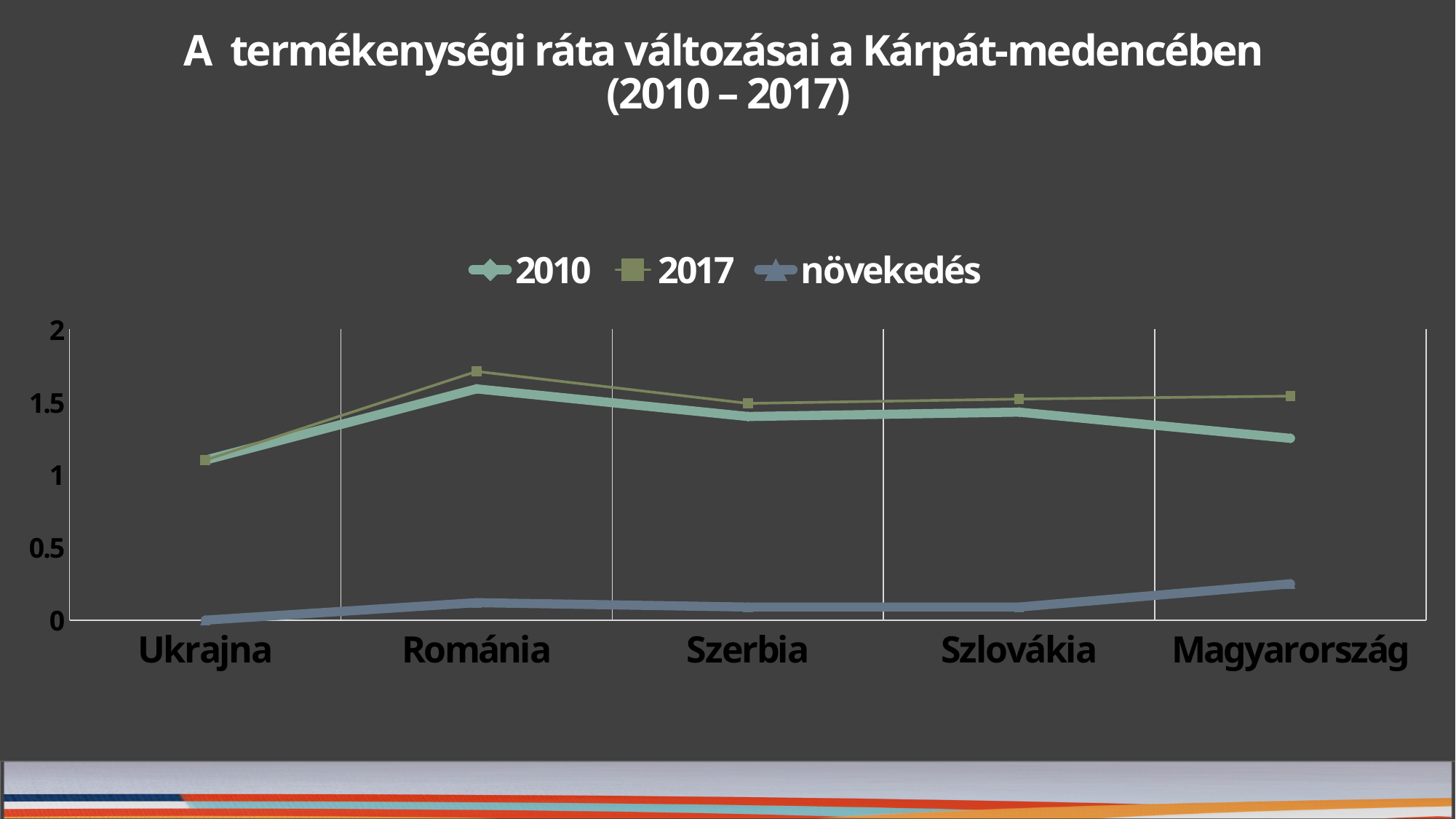
Is the 2010 value for Ukrajna greater or less than 1.5? less What kind of chart is shown on the slide? line chart Which country has the highest value in the 2010 series? Románia Which country has the highest value in the növekedés series? Magyarország What is the title of the chart? A termékenységi ráta változásai a Kárpát-medencében (2010 – 2017) How many countries are shown on the x axis? 5 Which country has the highest value in the 2017 series? Románia How many series does the legend list? 3 Is the 2017 value for Románia greater or less than 1.5? greater Is the növekedés value for Magyarország greater or less than 0.5? less For Magyarország, which is larger: the 2010 value or the 2017 value? 2017 Which country has the lowest value in the 2010 series? Ukrajna